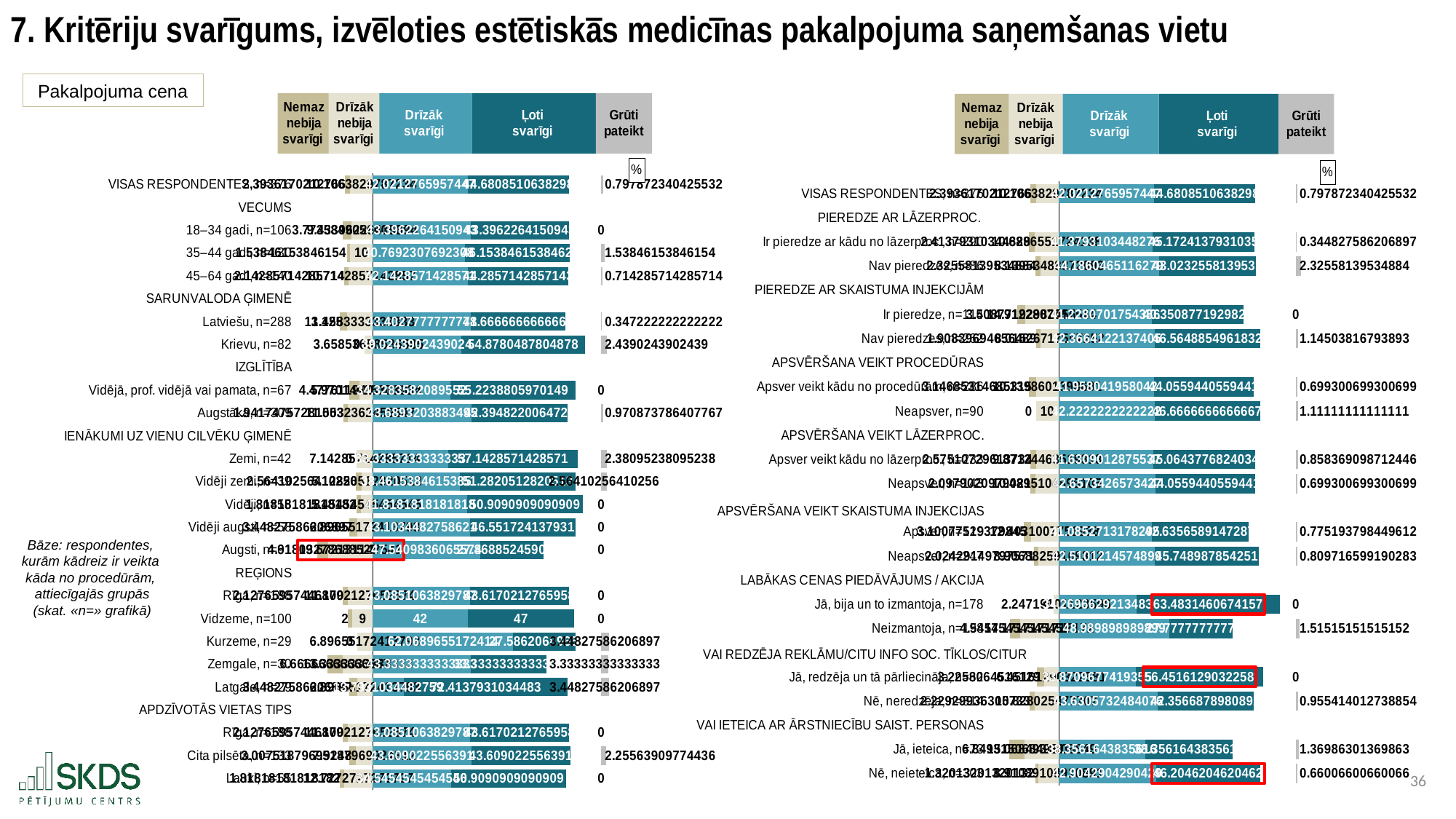
In the left chart, which has the larger 'Grūti pateikt' value: Latviešu, n=288 or Krievu, n=82? Krievu, n=82 In the right chart, what is the 'Grūti pateikt' value for 'Neapsver, n=90'? 1.11111111111111 In the left chart, what is the difference between 'Ļoti svarīgi' and 'Drīzāk svarīgi' for Vidzeme, n=100? 5 In the right chart, what is the 'Grūti pateikt' value for 'VISAS RESPONDENTES'? 0.797872340425532 In the left chart, what is the value of 'Ļoti svarīgi' for Vidzeme, n=100? 47 In the left chart, for Vidzeme, n=100, which is larger: 'Drīzāk svarīgi' or 'Ļoti svarīgi'? Ļoti svarīgi In the left chart, what is the 'Grūti pateikt' value for Krievu, n=82? 2.4390243902439 How many series does the legend of the left chart list? 5 In the left chart, what is the value of 'Drīzāk svarīgi' for Vidzeme, n=100? 42 In the right chart, what is the 'Ļoti svarīgi' value for 'Nē, neieteica'? 46.2046204620462 In the right chart, what is the 'Ļoti svarīgi' value for 'Jā, bija un to izmantoja, n=178'? 63.4831460674157 What kind of chart is shown on the left side of the slide? bar chart